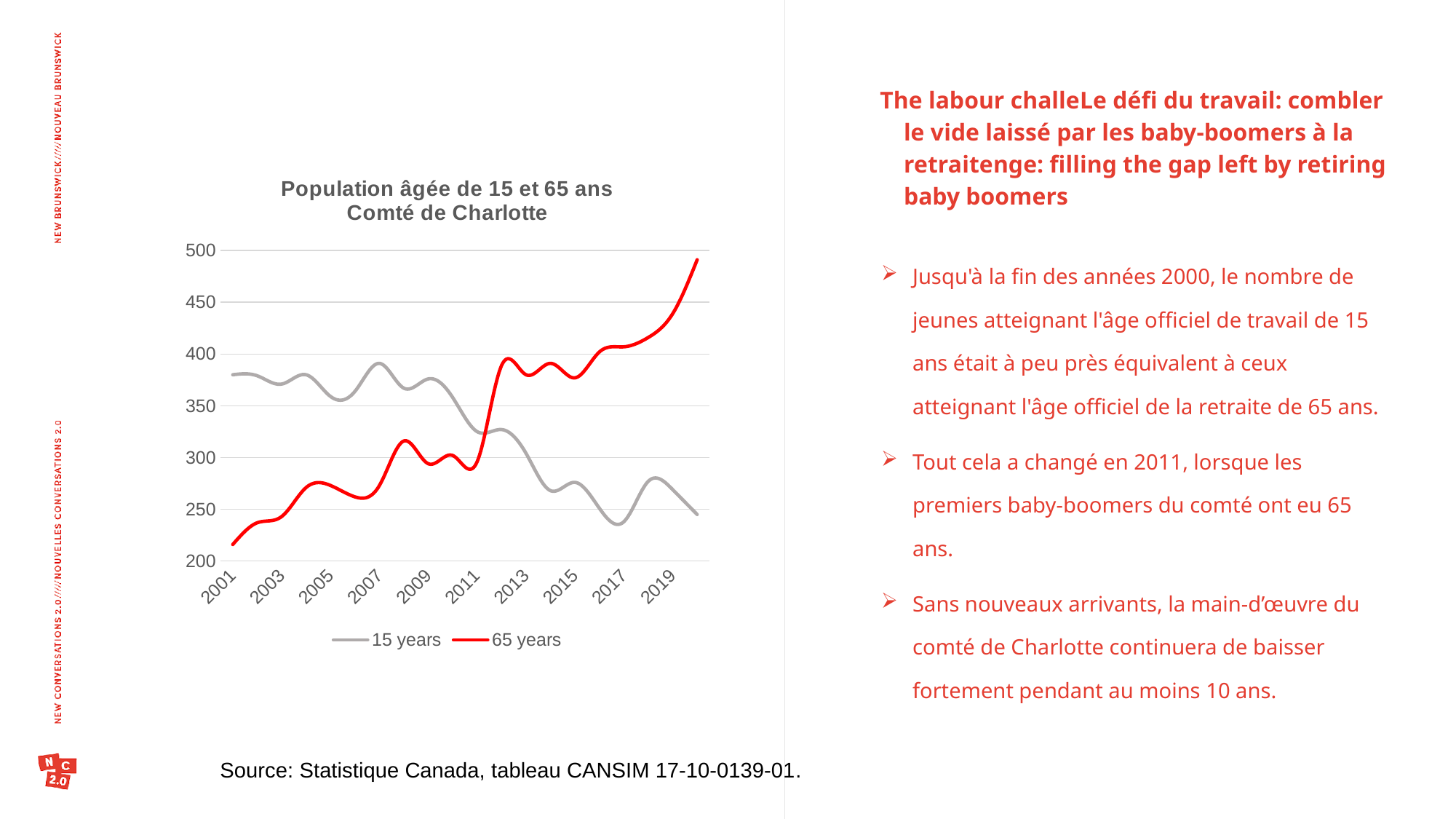
In 2019, which series has the larger value, 15 years or 65 years? 65 years What is the title of the chart? Population âgée de 15 et 65 ans Comté de Charlotte Is the value for 65 years in 2001 greater or less than 250? less Does the 15 years line rise or fall overall from 2001 to 2019? fall What are the two series named in the legend? 15 years and 65 years Does the 65 years line rise or fall overall from 2001 to 2019? rise Is the value for 15 years in 2001 greater or less than 350? greater What kind of chart is shown on the slide? line chart Is the value for 65 years in 2019 greater or less than 400? greater How many series does the legend list? 2 In 2001, which series has the larger value, 15 years or 65 years? 15 years